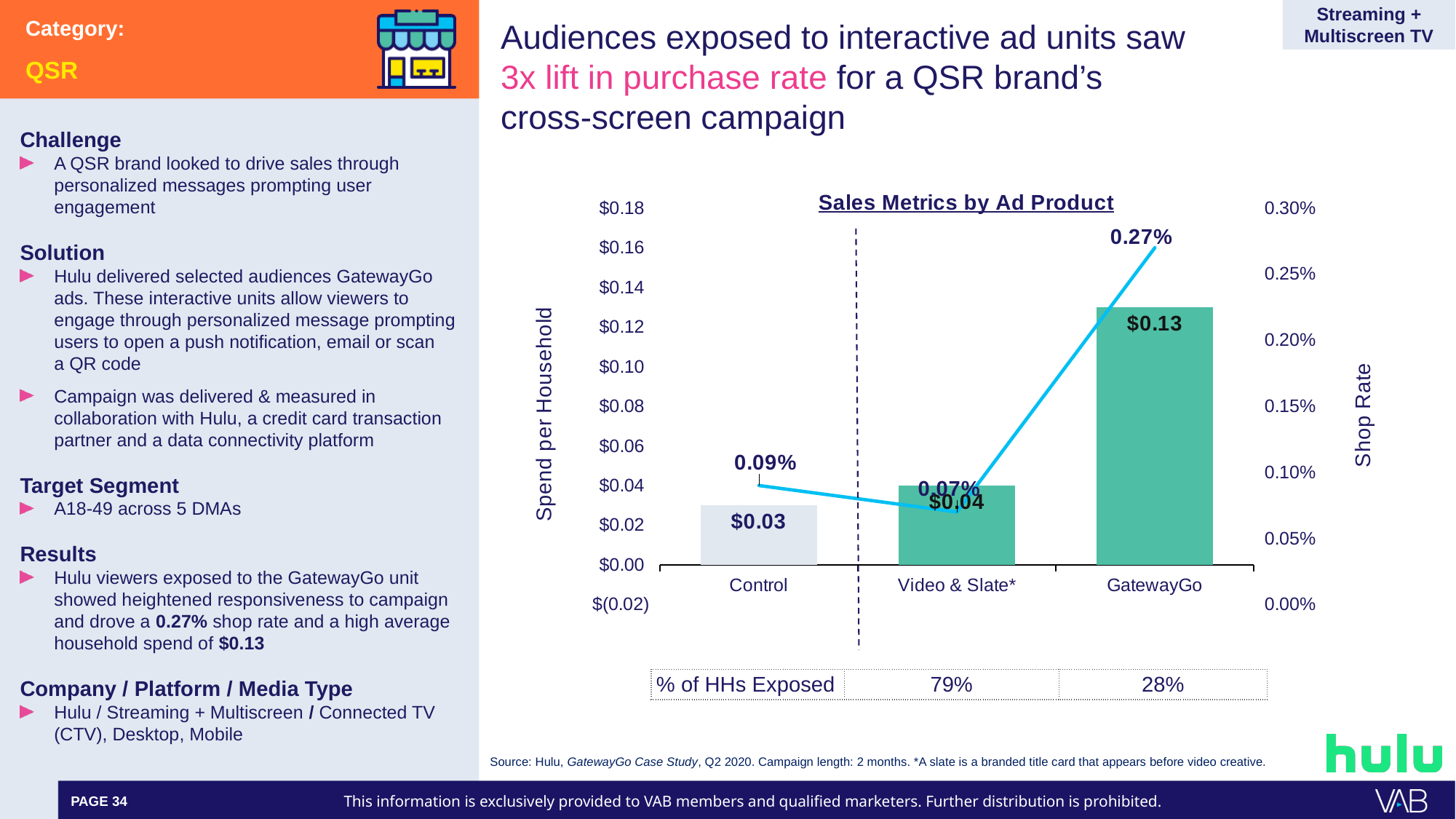
What is the spend per household for the Control group? $0.03 What is the label of the left vertical axis of the chart? Spend per Household What is the spend per household for GatewayGo? $0.13 What is the shop rate for GatewayGo? 0.27% Which category has the lowest shop rate? Video & Slate* What is the title of the chart? Sales Metrics by Ad Product What is the difference in spend per household between GatewayGo and Control? $0.10 What is the spend per household for Video & Slate*? $0.04 Which ad product has the highest spend per household? GatewayGo What is the shop rate for the Control group? 0.09% How many categories are shown on the x axis of the chart? 3 Which has a higher shop rate, Control or Video & Slate*? Control